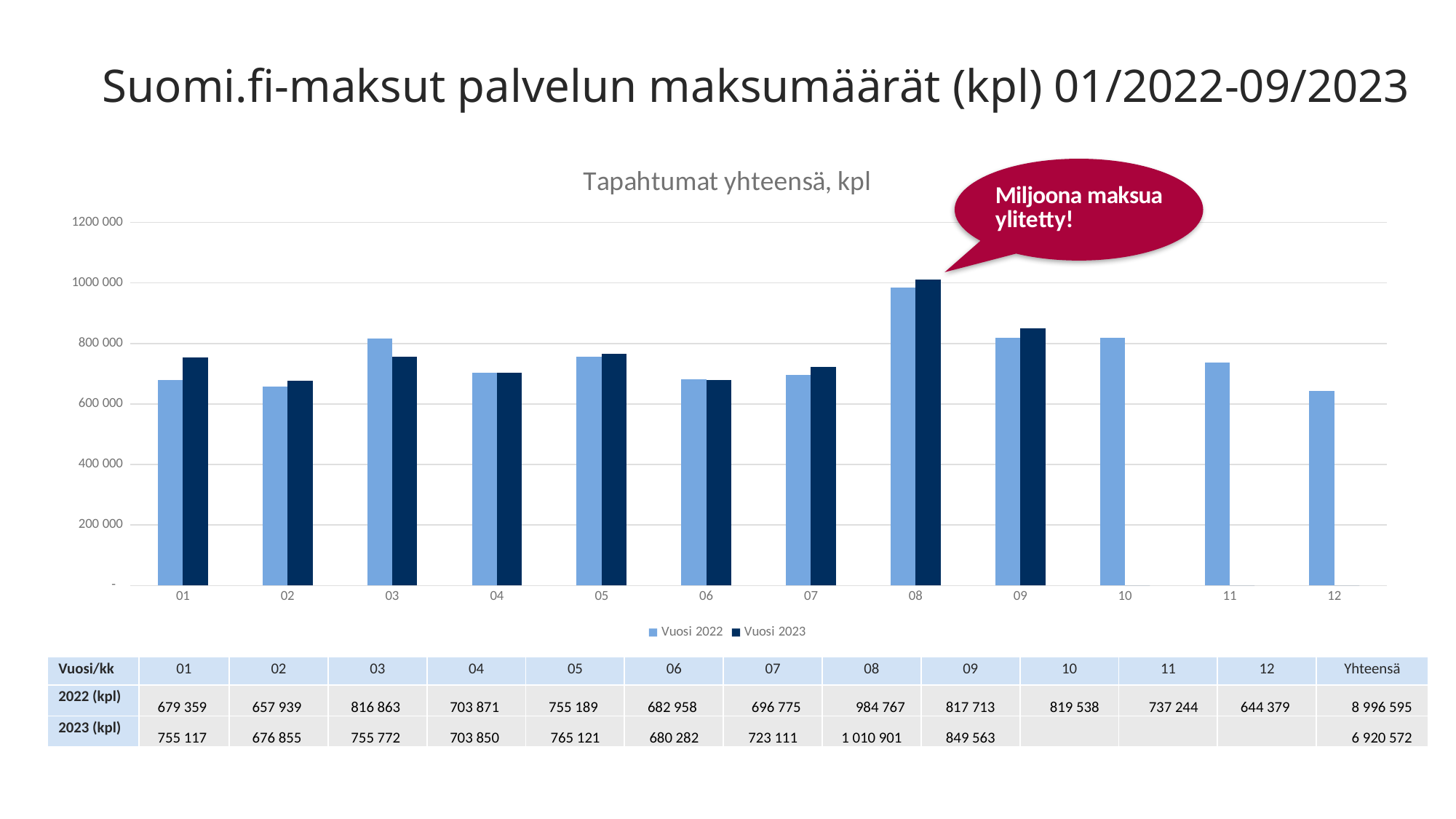
Which month has the highest value for Vuosi 2022? 08 How many months are shown on the x axis of the chart? 12 What is the title of the chart? Tapahtumat yhteensä, kpl How many series does the chart legend list? 2 What is the difference between the Vuosi 2023 and Vuosi 2022 values in month 01? 75 758 Which month has the lowest value for Vuosi 2023? 02 What is the total (Yhteensä) for 2022 (kpl) in the table? 8 996 595 What is the value for Vuosi 2023 in month 08? 1 010 901 What is the value for Vuosi 2022 in month 03? 816 863 In month 03, which series has the larger value, Vuosi 2022 or Vuosi 2023? Vuosi 2022 What kind of chart is shown on the slide? bar chart Is the value for Vuosi 2023 in month 08 greater or less than 1 000 000? greater